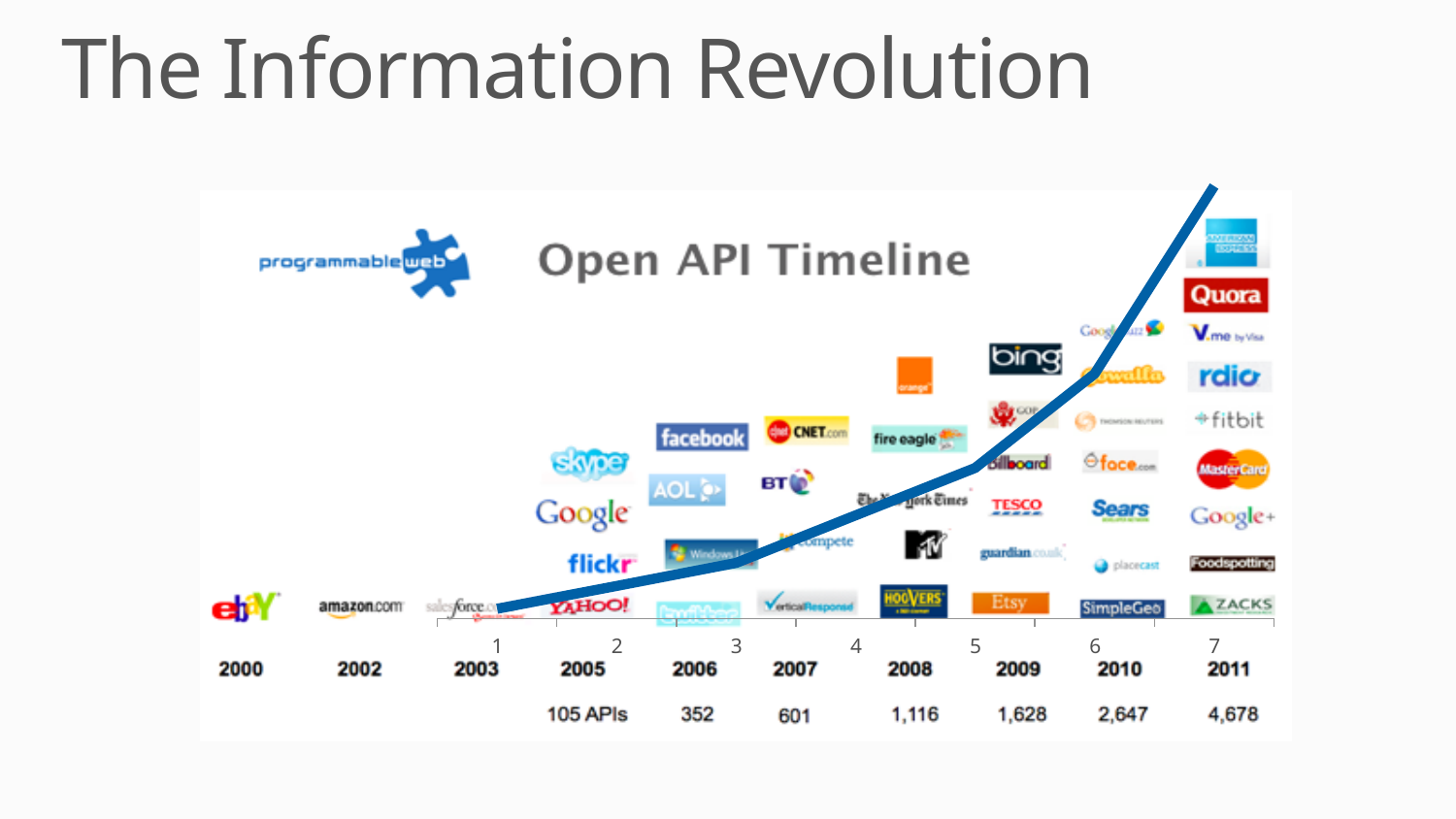
Which year with a printed API count on the Open API Timeline has the lowest number? 2005 What is the number of APIs shown for 2008 on the Open API Timeline? 1,116 Which year has the larger API count on the Open API Timeline, 2008 or 2009? 2009 What is the title printed on the timeline image? Open API Timeline How many numbered points are marked along the x axis of the line chart? 7 What kind of chart is overlaid on the Open API Timeline image? line chart What is the difference between the API counts for 2011 and 2010 on the Open API Timeline? 2,031 Which year on the Open API Timeline has the highest number of APIs? 2011 What is the number of APIs shown for 2011 on the Open API Timeline? 4,678 Does the line on the Open API Timeline chart rise or fall from left to right? rise What is the number of APIs shown for 2010 on the Open API Timeline? 2,647 How many APIs are listed for 2005 on the Open API Timeline? 105 APIs